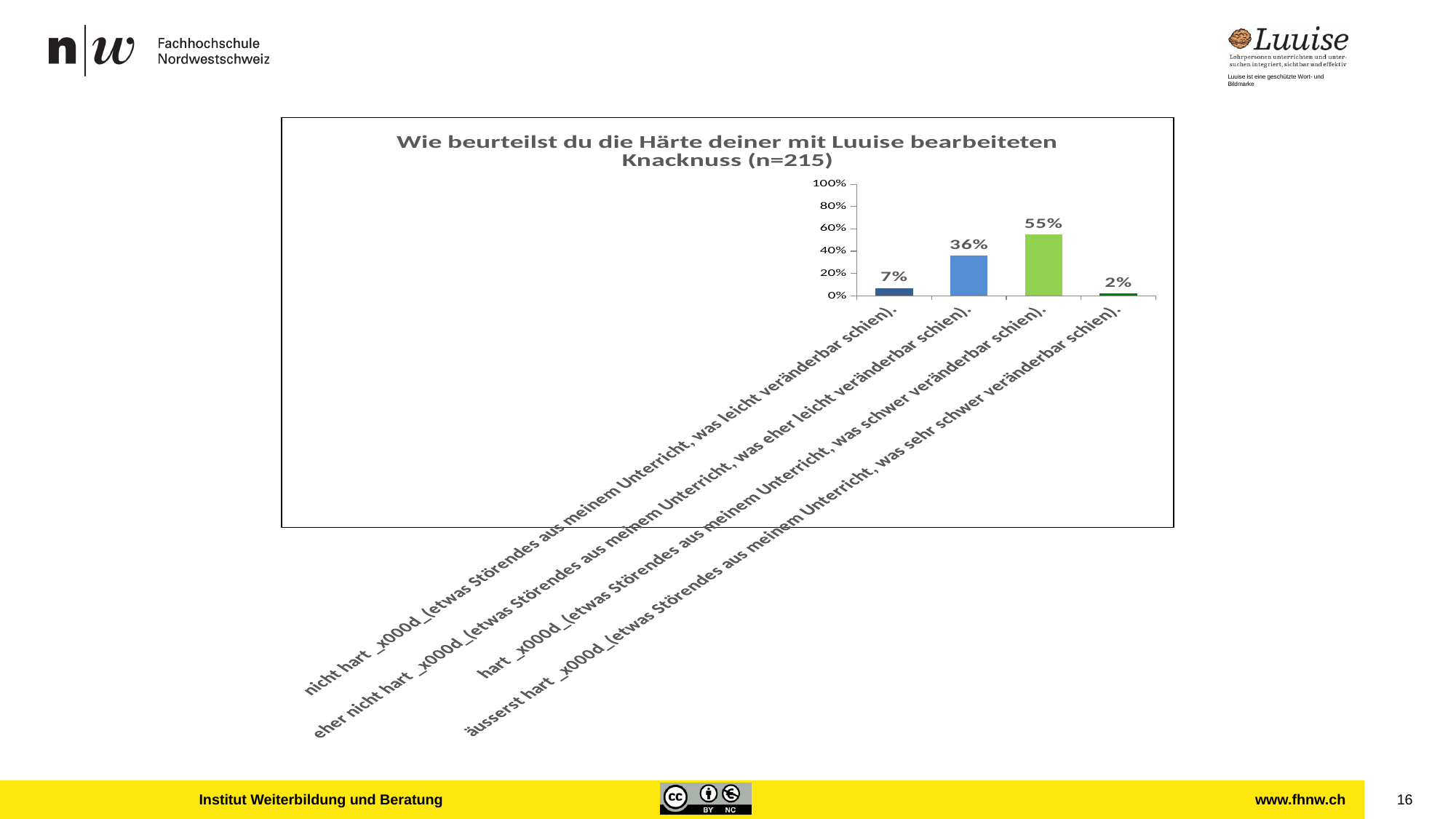
What percentage of respondents rated their Knacknuss as "hart"? 55% How many categories are shown in the chart? 4 Which category has the highest value? hart What is the value shown for the "eher nicht hart" category? 36% What is the value shown for the "nicht hart" category? 7% What sample size (n) is stated in the chart title? n=215 What is the difference between the values for "hart" and "eher nicht hart"? 19% Is the value for "hart" greater or less than 40%? greater What is the value shown for the "äusserst hart" category? 2% Which category has the lowest value? äusserst hart Which is larger, the value for "nicht hart" or the value for "äusserst hart"? nicht hart What kind of chart is shown on the slide? bar chart